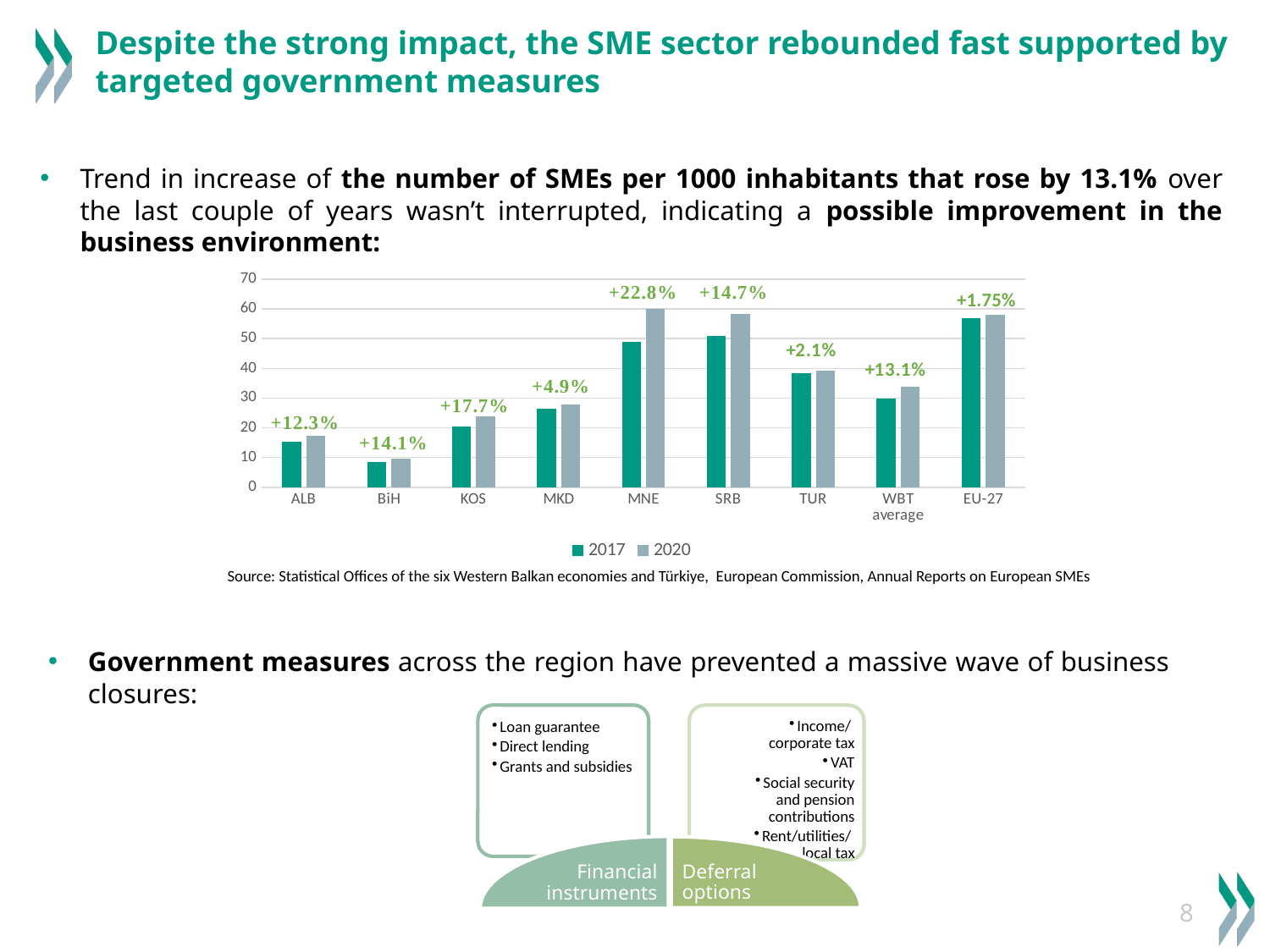
How many series does the chart legend list? 2 Which category has the highest percentage change label in the chart? MNE What kind of chart is shown on the slide? bar chart What percentage change is labelled above the bars for KOS? +17.7% Is the 2020 value for MNE greater or less than 50? greater Which is larger, the 2020 value for ALB or the 2020 value for KOS? KOS Which category has the lowest 2017 bar in the chart? BiH What percentage change is labelled above the bars for the WBT average? +13.1% What percentage change is labelled above the bars for MNE? +22.8% Is the 2017 value for BiH greater or less than 10? less How many categories are shown on the x axis of the chart? 9 Which category has the lowest percentage change label in the chart? EU-27